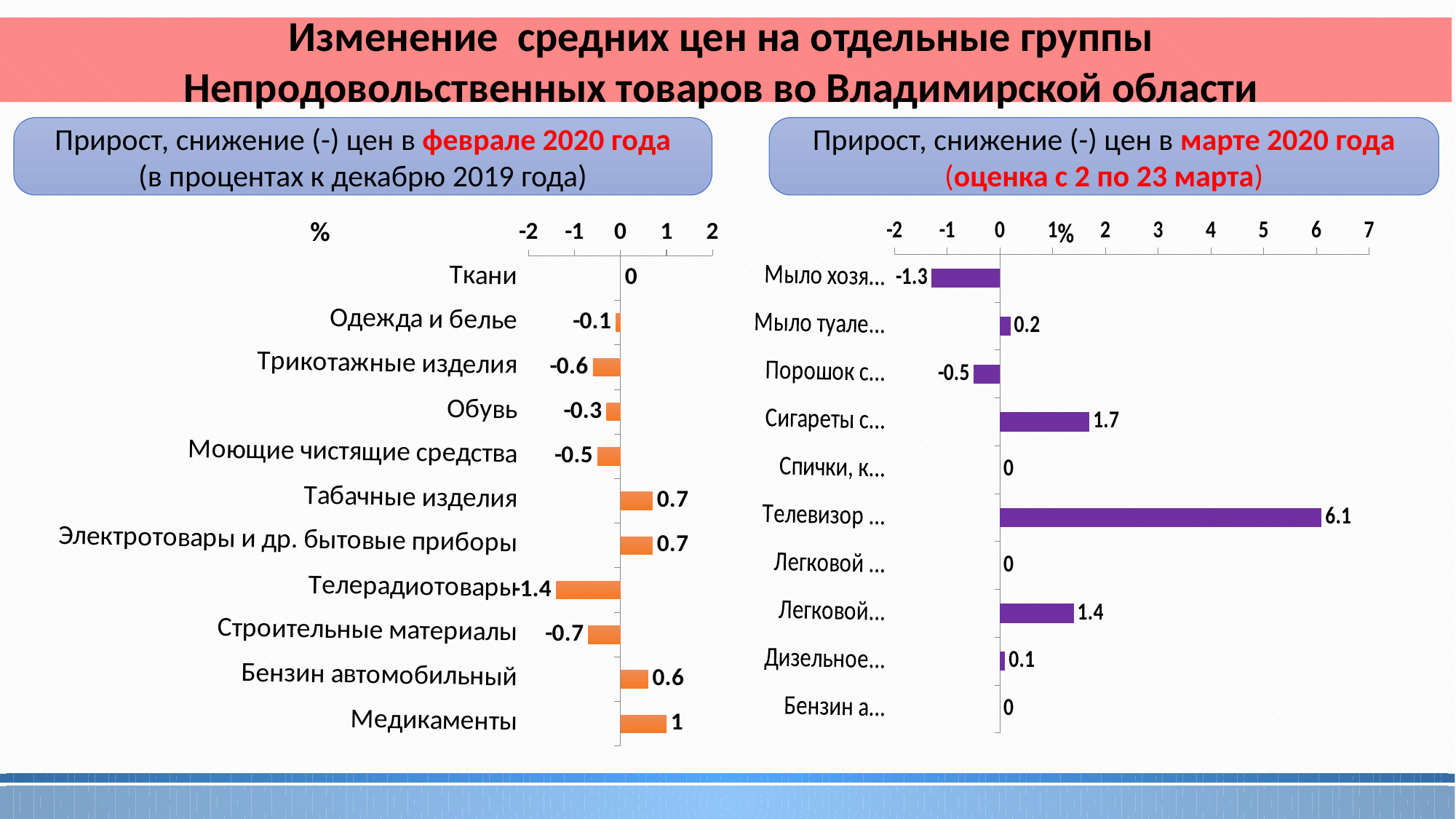
On the February 2020 chart (left), what is the value for Строительные материалы? -0.7 On the February 2020 chart (left), what is the value for Телерадиотовары? -1.4 On the March 2020 chart (right), how many categories are shown? 10 On the February 2020 chart (left), how many categories are shown? 11 On the February 2020 chart (left), what is the value for Медикаменты? 1 On the February 2020 chart (left), which is larger: the value for Трикотажные изделия or the value for Обувь? Обувь On the February 2020 chart (left), which category has the lowest value? Телерадиотовары On the February 2020 chart (left), which category has the highest value? Медикаменты On the March 2020 chart (right), what is the value for the category labelled Сигареты с...? 1.7 On the February 2020 chart (left), what is the difference between the values for Медикаменты and Бензин автомобильный? 0.4 On the March 2020 chart (right), what is the highest value shown? 6.1 What kind of chart is the February 2020 chart on the left? bar chart